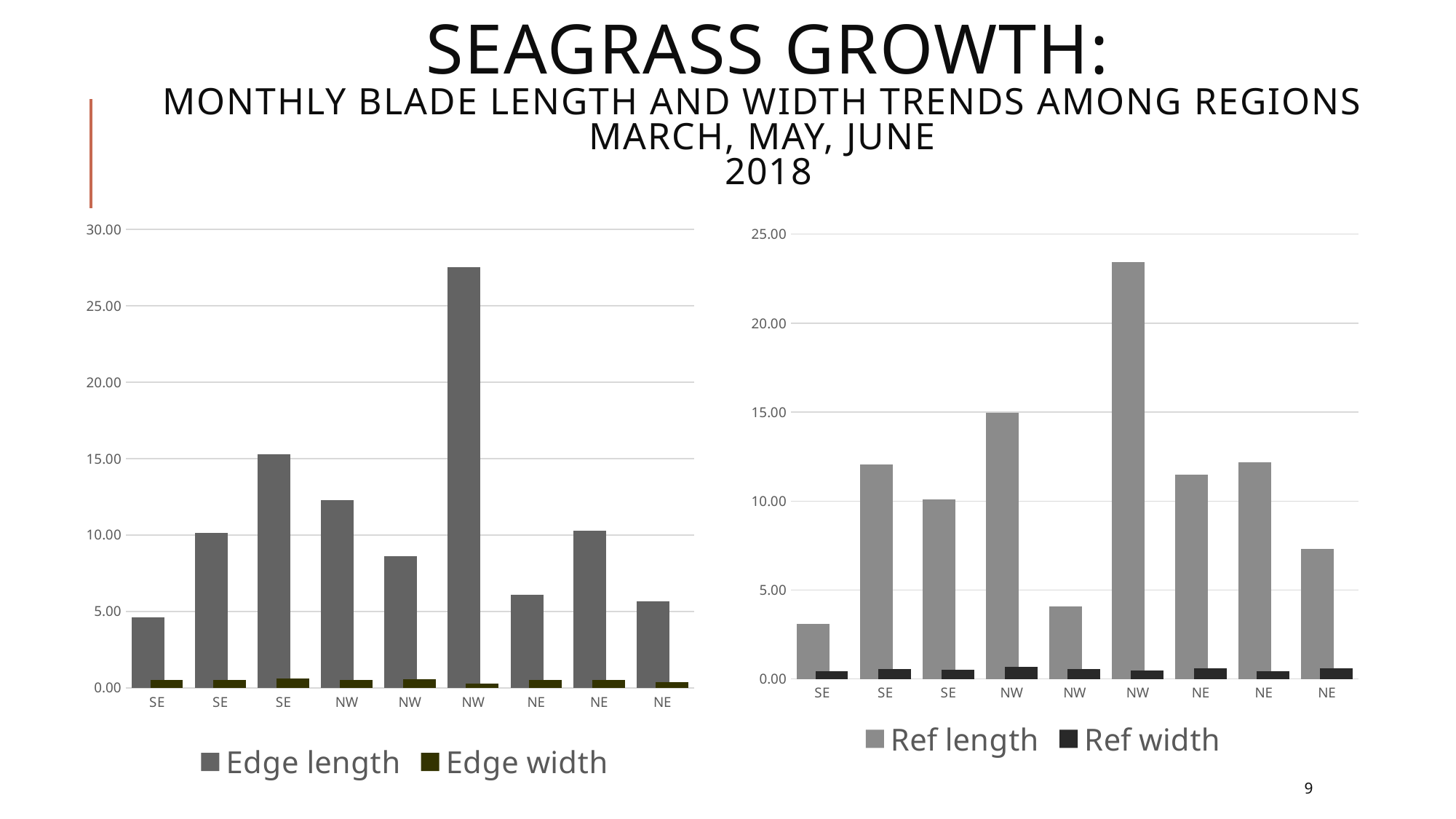
In the right chart, is the Ref length value for the third NE bar greater or less than 10.00? less What kind of chart is the left chart with the Edge length and Edge width legend? bar chart In the right chart, is the Ref length value for the first SE bar greater or less than 5.00? less In the left chart, which bar has the highest Edge length value? the third NW bar What are the two legend entries of the right chart? Ref length and Ref width In the left chart, is the Edge length value for the third NW bar greater or less than 25.00? greater How many category labels are shown along the x axis of the left chart? 9 In the left chart, which is larger: the Edge length for the third SE bar or the Edge length for the first NW bar? the third SE bar In the right chart, which bar has the highest Ref length value? the third NW bar How many series does the legend of the right chart list? 2